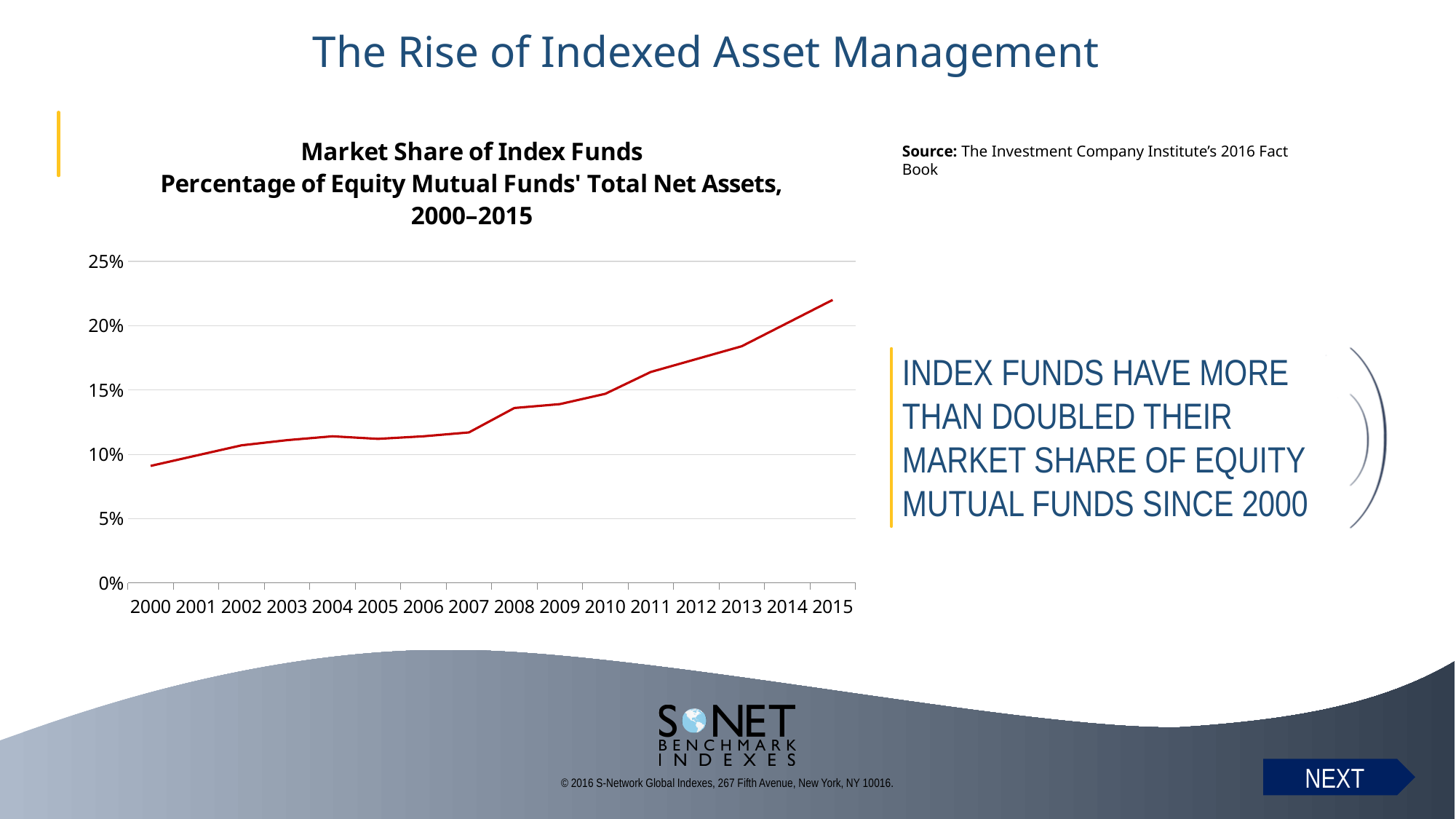
Is the value for 2015 greater or less than 20%? greater Which year has the highest market share of index funds in the chart? 2015 What colour is the line in the chart? red Is the value for 2008 greater or less than 15%? less Which year has the larger value, 2005 or 2013? 2013 What kind of chart is shown on the slide? line chart Which year has the lowest market share of index funds in the chart? 2000 What is the title of the chart? Market Share of Index Funds Percentage of Equity Mutual Funds' Total Net Assets, 2000–2015 Do the values in the chart generally rise or fall from 2000 to 2015? rise Is the value for 2011 greater or less than 15%? greater How many years are plotted along the x axis of the chart? 16